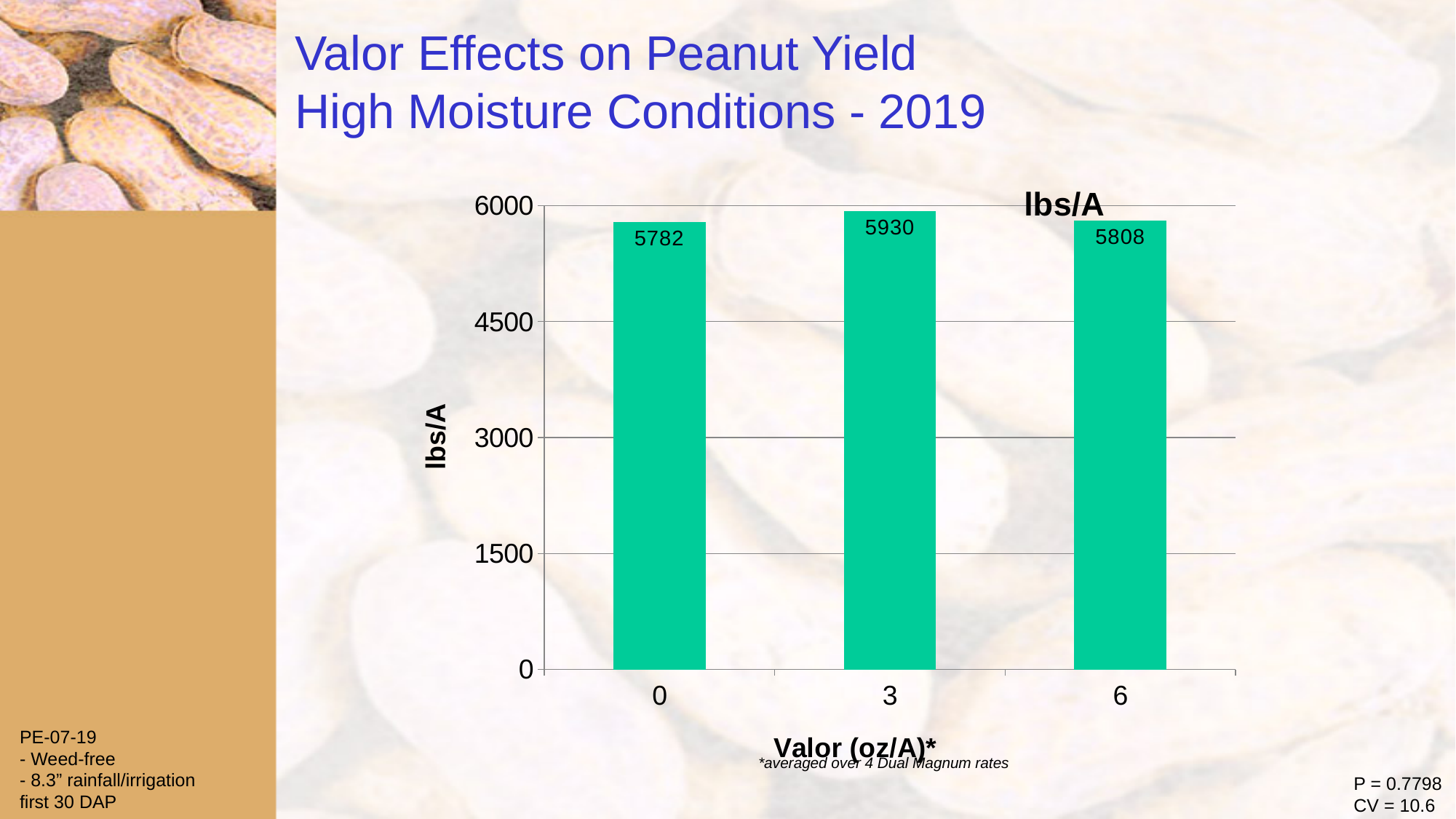
What kind of chart is shown on the slide? bar chart What is the label of the x axis? Valor (oz/A)* Which Valor rate has the lowest yield? 0 What is the yield (lbs/A) for the Valor rate of 3 oz/A? 5930 What is the difference in yield between the 3 oz/A and 6 oz/A Valor rates? 122 What is the yield (lbs/A) for the Valor rate of 0 oz/A? 5782 Is the yield for the 0 oz/A Valor rate greater or less than 4500? greater How many Valor rates are shown on the x axis? 3 What is the difference in yield between the 3 oz/A and 0 oz/A Valor rates? 148 Which Valor rate has the highest yield? 3 What is the yield (lbs/A) for the Valor rate of 6 oz/A? 5808 What is the label of the y axis? lbs/A